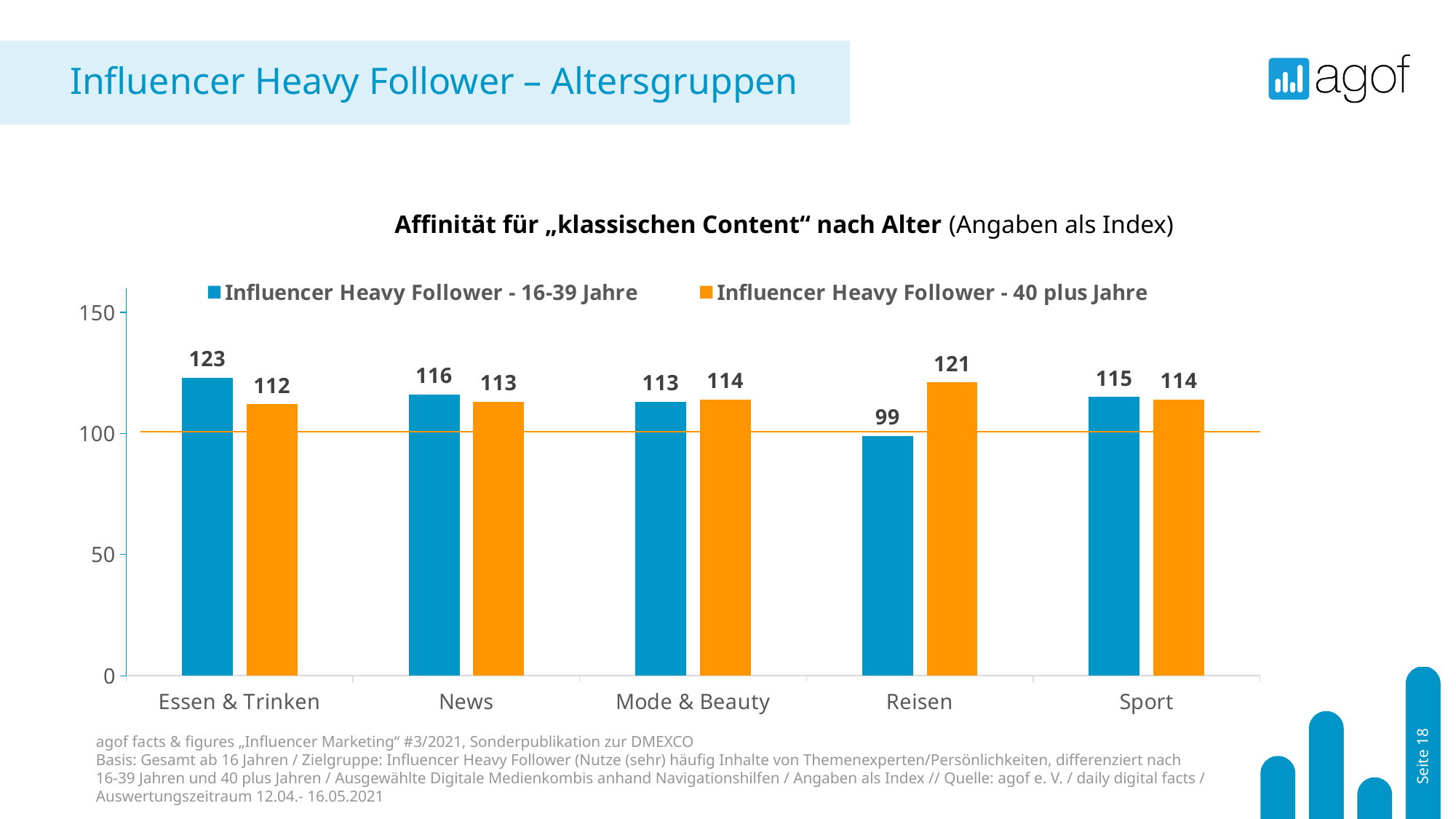
How many categories are shown on the x axis? 5 What is the index value for Sport for Influencer Heavy Follower - 16-39 Jahre? 115 Which category has the highest value for Influencer Heavy Follower - 16-39 Jahre? Essen & Trinken Which category has the lowest value for Influencer Heavy Follower - 16-39 Jahre? Reisen How many series does the legend list? 2 Which category has the highest value for Influencer Heavy Follower - 40 plus Jahre? Reisen What is the difference between the two age groups for Essen & Trinken? 11 What is the index value for Essen & Trinken for Influencer Heavy Follower - 16-39 Jahre? 123 What is the difference between the two age groups for Reisen? 22 What is the index value for Reisen for Influencer Heavy Follower - 40 plus Jahre? 121 For News, which age group has the larger value? Influencer Heavy Follower - 16-39 Jahre What kind of chart is shown on the slide? Bar chart